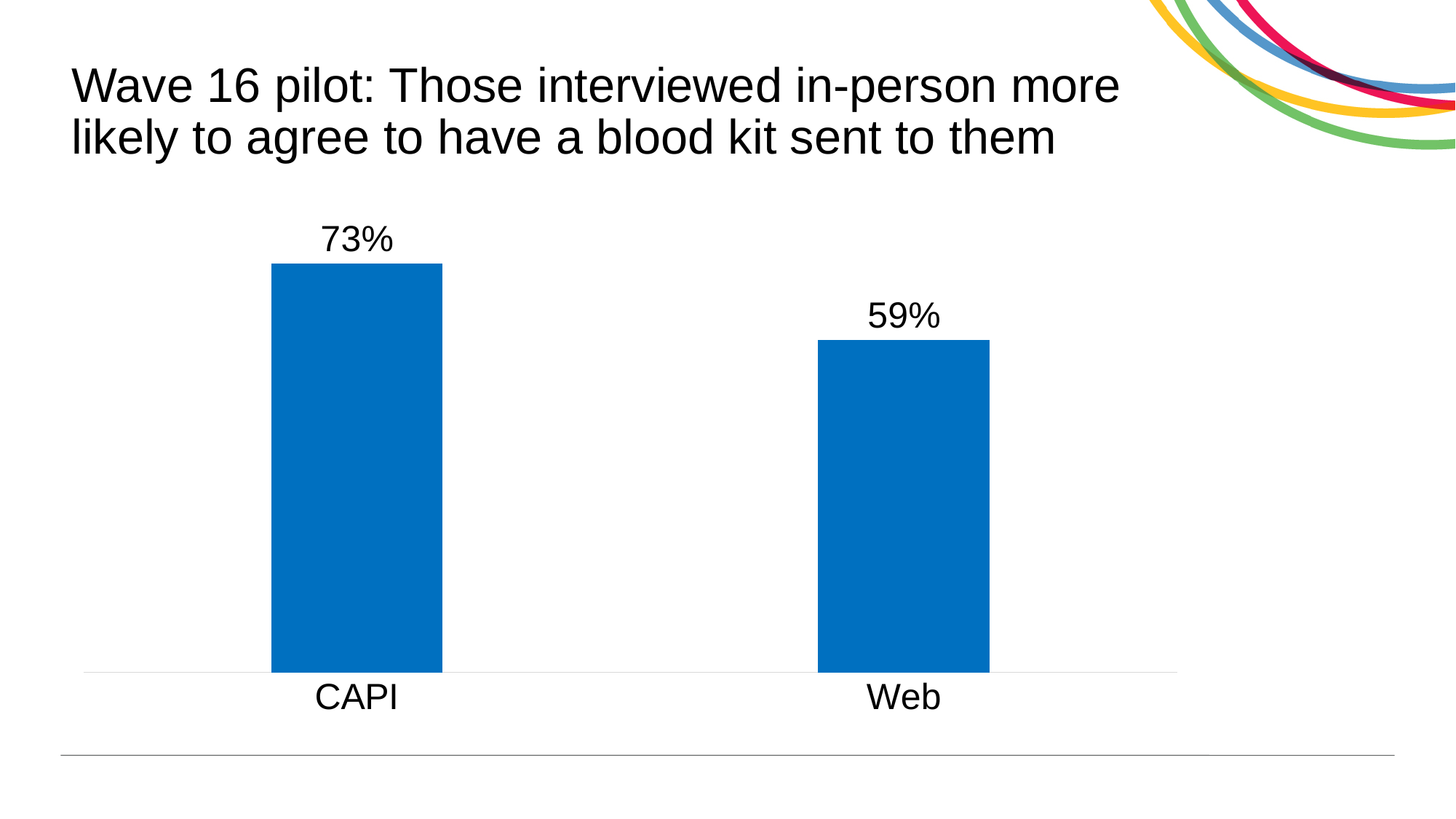
What is the value for Web? 59% What is the difference between the values for CAPI and Web? 14% Which category has the highest value? CAPI What colour are the bars in the chart? Blue What is the value for CAPI? 73% Which category has the lowest value? Web Which is larger, the value for CAPI or the value for Web? CAPI Do the values rise or fall from CAPI to Web? Fall What kind of chart is shown on the slide? Bar chart What is the title of the slide? Wave 16 pilot: Those interviewed in-person more likely to agree to have a blood kit sent to them How many categories are shown in the chart? 2